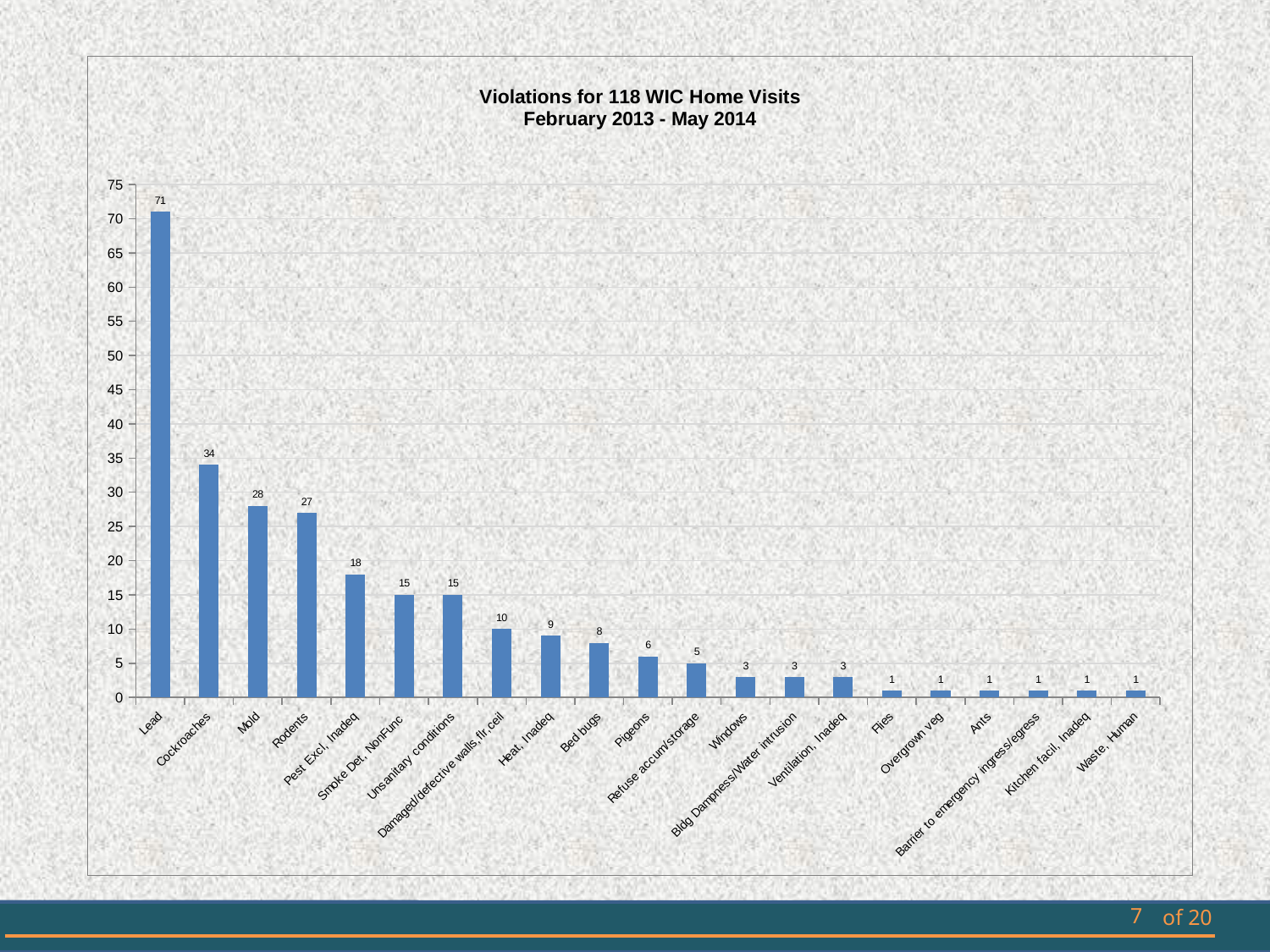
Is the value for Mold greater or less than 25? greater What is the value for Cockroaches? 34 What is the value for Rodents? 27 What kind of chart is shown on the slide? Bar chart Which category has the highest value? Lead What is the difference between the values for Mold and Rodents? 1 How many categories are shown on the x axis? 21 What is the value for Pigeons? 6 What is the value for Lead? 71 What is the difference between the values for Lead and Cockroaches? 37 What is the title of the chart? Violations for 118 WIC Home Visits February 2013 - May 2014 Which is larger, the value for Pest Excl, Inadeq or the value for Bed bugs? Pest Excl, Inadeq